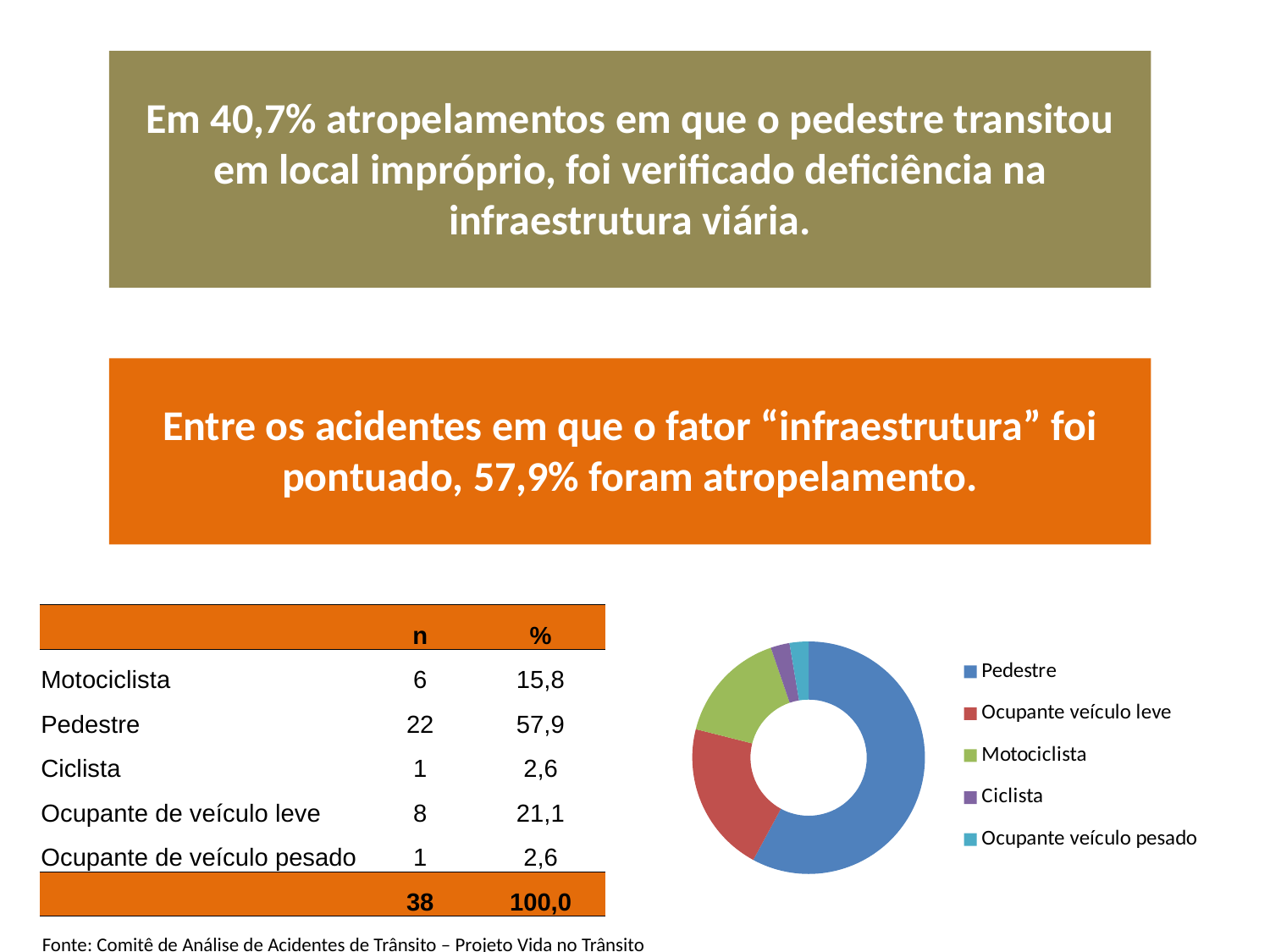
Which category has the largest slice in the doughnut chart? Pedestre What colour is the Pedestre slice in the doughnut chart? blue According to the table next to the chart, what is the total n across all categories? 38 According to the table next to the chart, what is the value of n for Motociclista? 6 What kind of chart is shown on the slide? doughnut (pie) chart Which slice is larger in the doughnut chart, Pedestre or Ocupante veículo leve? Pedestre According to the table next to the chart, what is the value of n for Pedestre? 22 Which category is listed first in the legend of the doughnut chart? Pedestre How many categories does the legend of the doughnut chart list? 5 Which slice is larger in the doughnut chart, Ocupante veículo leve or Motociclista? Ocupante veículo leve According to the table next to the chart, what percentage share does Pedestre have? 57,9 According to the table next to the chart, what is the difference in n between Pedestre and Ocupante de veículo leve? 14